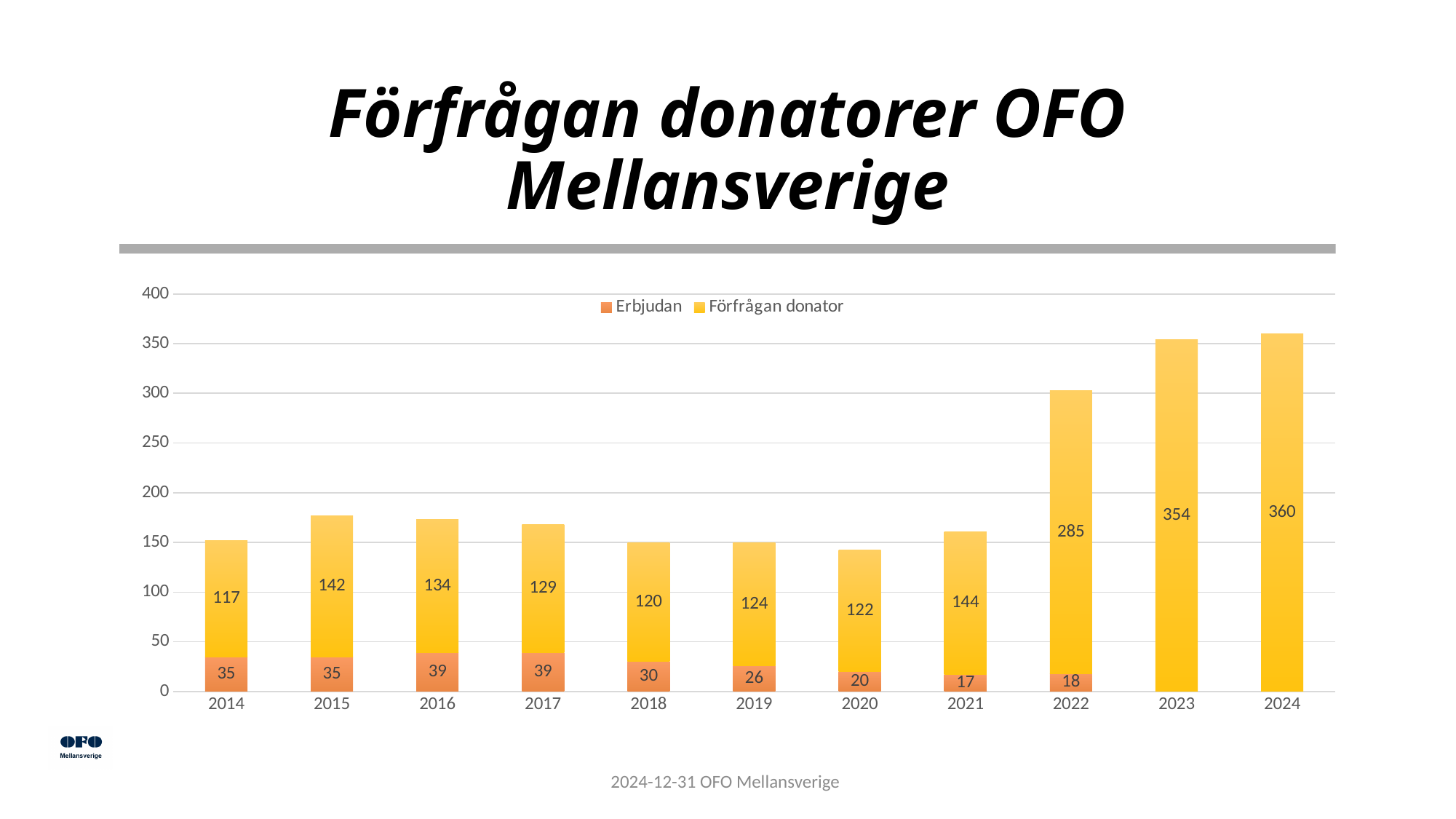
What kind of chart is shown on the slide? Stacked bar chart How many series does the legend list? 2 What is the total of the stacked bar for 2014? 152 Which year has the highest Förfrågan donator value? 2024 What is the value of Erbjudan for 2016? 39 What is the value of Förfrågan donator for 2022? 285 Which is larger, the Förfrågan donator value for 2015 or for 2017? 2015 Is the total height of the 2022 bar greater or less than 300? greater How many years are shown on the x axis? 11 What is the value of Förfrågan donator for 2018? 120 What is the difference between the Förfrågan donator values for 2024 and 2023? 6 Which year has the lowest Erbjudan value among the years with an Erbjudan label? 2021